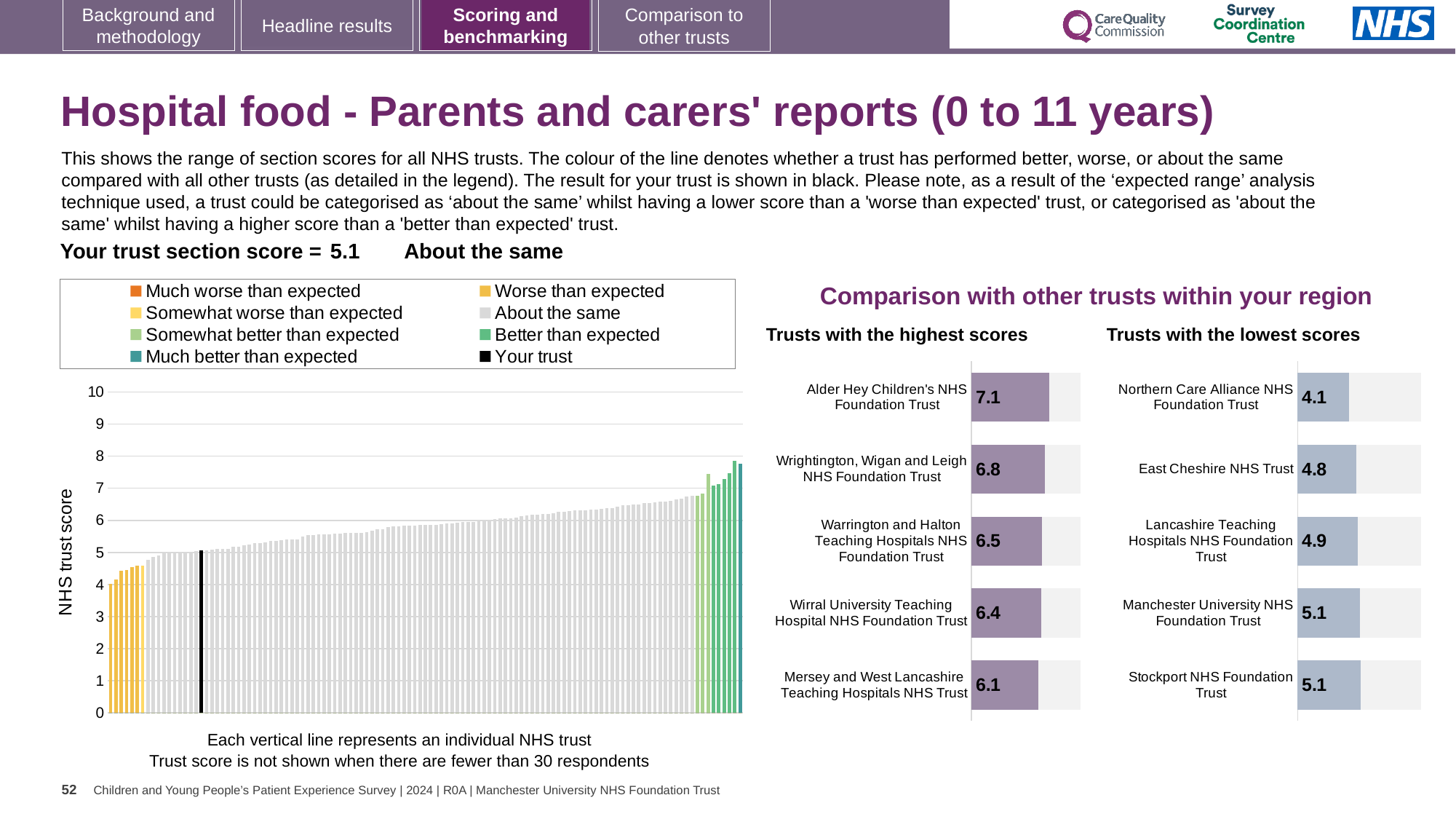
In the 'Trusts with the highest scores' chart, what is the difference between the scores of Alder Hey Children's NHS Foundation Trust and Wirral University Teaching Hospital NHS Foundation Trust? 0.7 In the 'Trusts with the lowest scores' chart, what is the difference between the scores of East Cheshire NHS Trust and Northern Care Alliance NHS Foundation Trust? 0.7 In the main 'NHS trust score' chart, is the value of the tallest bar greater or less than 7? greater In the main 'NHS trust score' chart, do the trust scores rise or fall from left to right? rise How many entries does the legend of the main 'NHS trust score' chart list? 8 In the 'Trusts with the lowest scores' chart, what is the score for Northern Care Alliance NHS Foundation Trust? 4.1 In the 'Trusts with the highest scores' chart, which has the higher score: Wrightington, Wigan and Leigh NHS Foundation Trust or Warrington and Halton Teaching Hospitals NHS Foundation Trust? Wrightington, Wigan and Leigh NHS Foundation Trust In the 'Trusts with the highest scores' chart, what is the score for Alder Hey Children's NHS Foundation Trust? 7.1 How many trusts are listed in the 'Trusts with the lowest scores' chart? 5 In the main 'NHS trust score' chart, what is the section score for your trust (the black bar)? 5.1 In the 'Trusts with the lowest scores' chart, which trust has the highest score? Manchester University NHS Foundation Trust and Stockport NHS Foundation Trust (both 5.1) In the 'Trusts with the highest scores' chart, which trust has the lowest score? Mersey and West Lancashire Teaching Hospitals NHS Trust